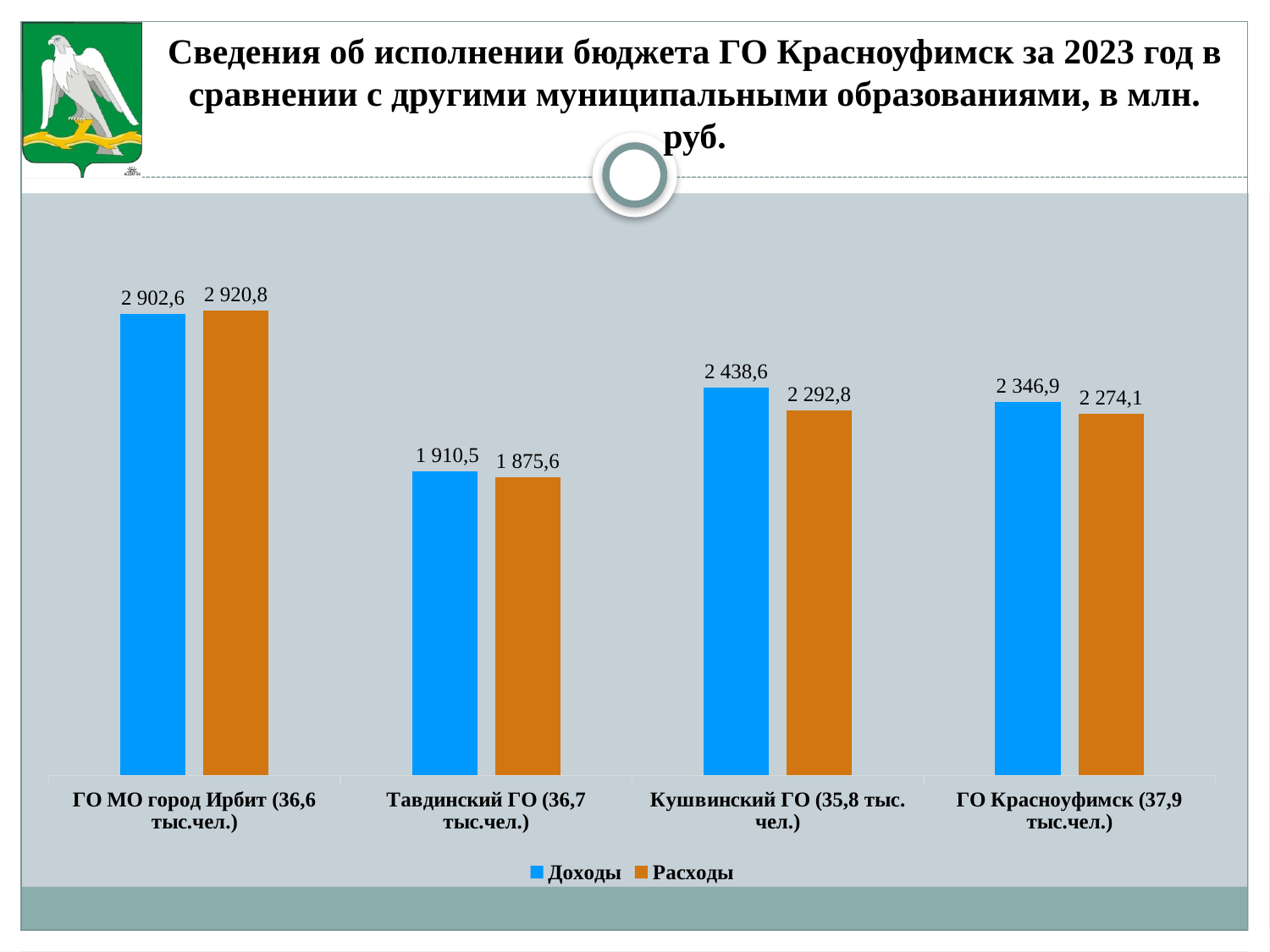
What is the value of Расходы for ГО МО город Ирбит (36,6 тыс.чел.)? 2 920,8 What is the value of Расходы for ГО Красноуфимск (37,9 тыс.чел.)? 2 274,1 What is the value of Доходы for Тавдинский ГО (36,7 тыс.чел.)? 1 910,5 What is the value of Доходы for Кушвинский ГО (35,8 тыс. чел.)? 2 438,6 How many series does the legend list? 2 What is the difference between Доходы and Расходы for Кушвинский ГО (35,8 тыс. чел.)? 145,8 How many municipalities are shown on the chart? 4 What type of chart is shown on the slide? Bar chart What is the difference between Доходы and Расходы for ГО Красноуфимск (37,9 тыс.чел.)? 72,8 Which is larger for Тавдинский ГО (36,7 тыс.чел.): Доходы or Расходы? Доходы Which municipality has the lowest Расходы value? Тавдинский ГО (36,7 тыс.чел.) Which municipality has the highest Доходы value? ГО МО город Ирбит (36,6 тыс.чел.)